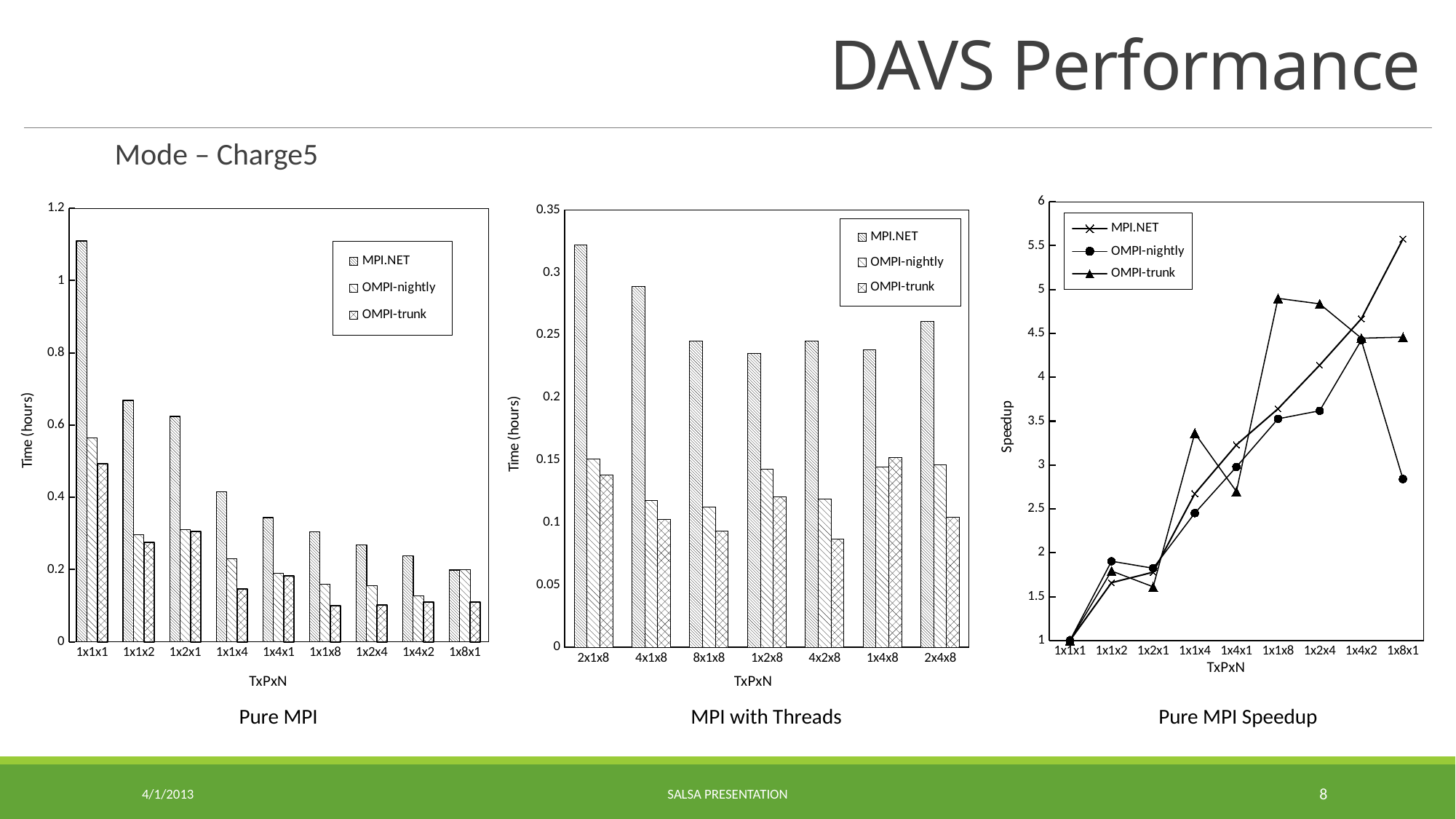
On the MPI with Threads chart, is the OMPI-trunk value for 4x2x8 greater or less than 0.1? less On the Pure MPI Speedup chart, is the MPI.NET speedup at 1x8x1 greater or less than 5? greater On the Pure MPI chart, how many TxPxN categories are shown on the x axis? 9 On the Pure MPI Speedup chart, which series has the higher speedup at 1x8x1: MPI.NET or OMPI-nightly? MPI.NET On the MPI with Threads chart, which TxPxN category has the highest MPI.NET time? 2x1x8 On the Pure MPI chart, do the MPI.NET times rise or fall moving from 1x1x1 to 1x8x1 along the x axis? fall On the Pure MPI chart, which TxPxN category has the highest MPI.NET time? 1x1x1 On the Pure MPI chart, is the MPI.NET value for 1x1x2 greater or less than 0.6? greater On the MPI with Threads chart, which is larger at 2x4x8: MPI.NET or OMPI-trunk? MPI.NET On the MPI with Threads chart, how many series does the legend list? 3 What kind of chart is the Pure MPI Speedup chart? line chart